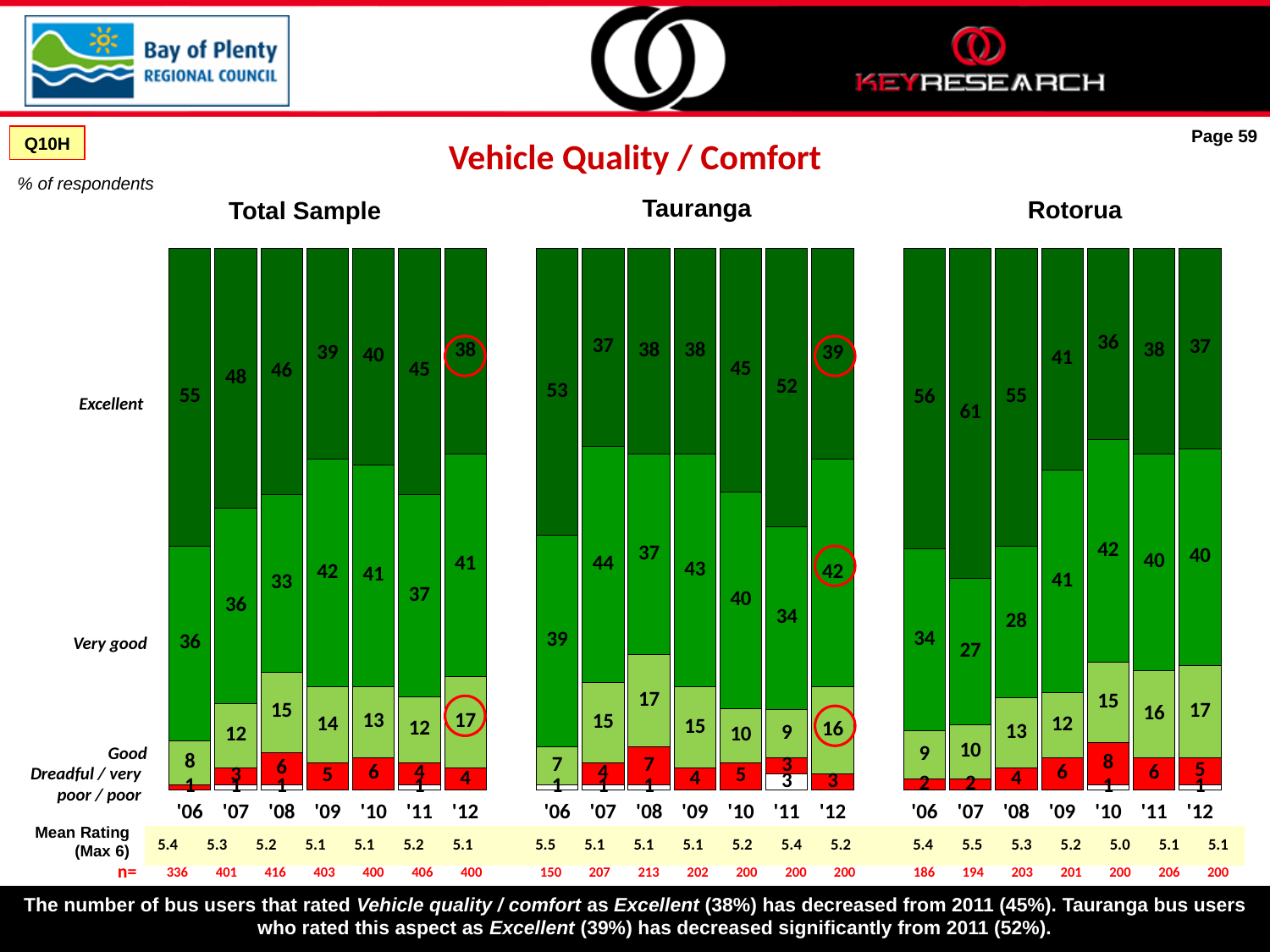
In the Rotorua chart, which year has the highest Excellent percentage? '07 In the Rotorua chart, what percentage rated vehicle quality / comfort as Excellent in '07? 61 In the Total Sample chart, what percentage rated vehicle quality / comfort as Good in '12? 17 In the Tauranga chart, what is the sample size (n=) for '06? 150 In the Tauranga chart, by how many percentage points did the Excellent rating fall from '11 to '12? 13 In the Tauranga chart, what percentage rated vehicle quality / comfort as Very good in '12? 42 What kind of chart is used to show the Total Sample results? Stacked bar chart How many years are shown on the x axis of each chart? 7 In the Total Sample chart, what percentage of respondents rated vehicle quality / comfort as Excellent in '12? 38 In the Total Sample chart, which year has the lowest Excellent percentage? '12 In the Total Sample chart, is the Excellent percentage higher in '11 or in '12? '11 In the Rotorua chart, what is the mean rating (Max 6) for '10? 5.0